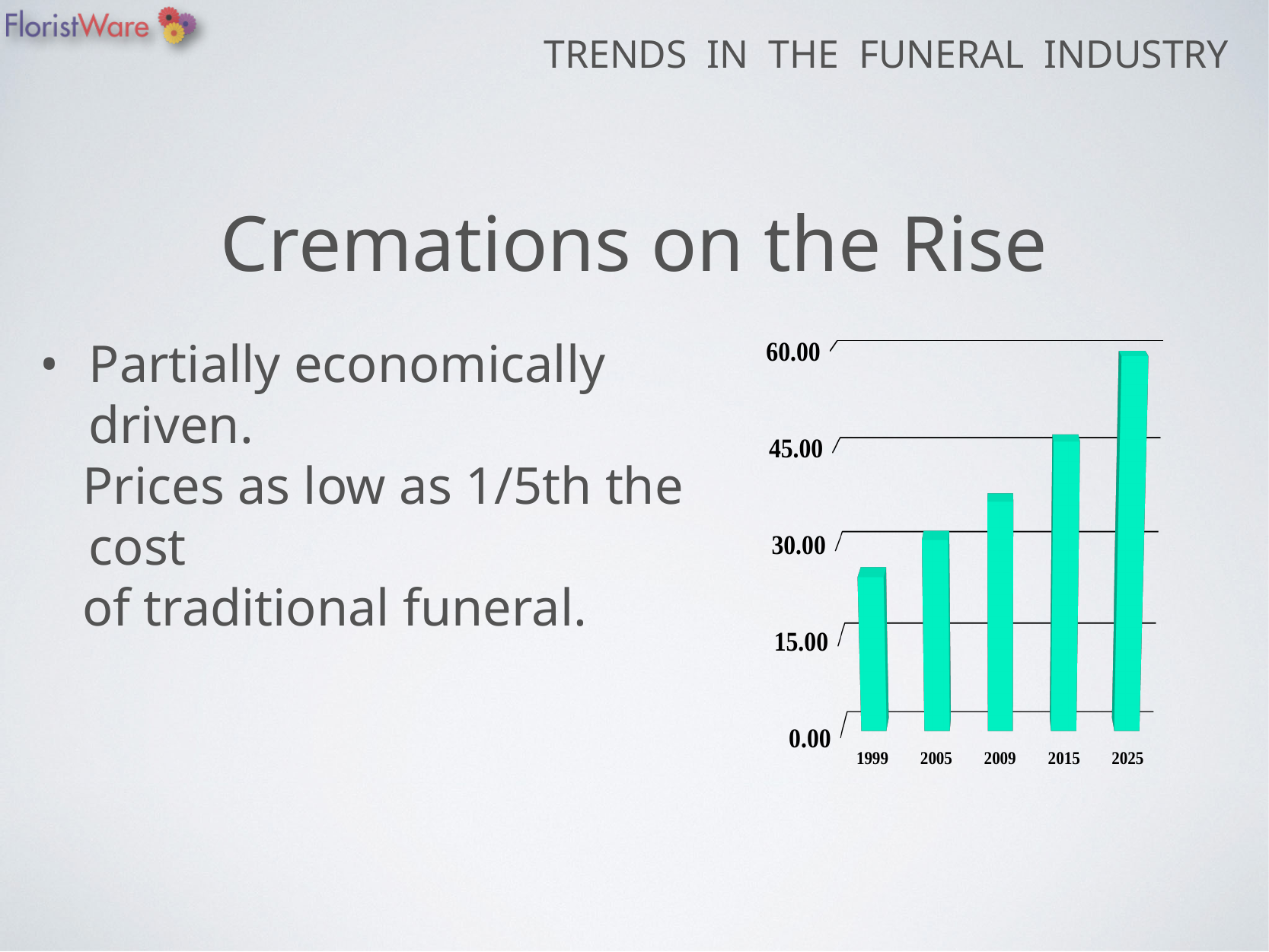
What kind of chart is shown on the slide? bar chart Which year has the highest bar in the chart? 2025 What is the highest value labelled on the vertical axis of the chart? 60.00 Is the value for 2009 greater or less than 45.00? less Is the value for 2009 greater or less than 30.00? greater Which is larger, the value for 2015 or the value for 2005? 2015 How many years are shown on the x axis of the chart? 5 Do the values rise or fall from 1999 to 2025 in the chart? rise Is the value for 2025 greater or less than 45.00? greater Which year has the lowest bar in the chart? 1999 What is the first year shown on the x axis of the chart? 1999